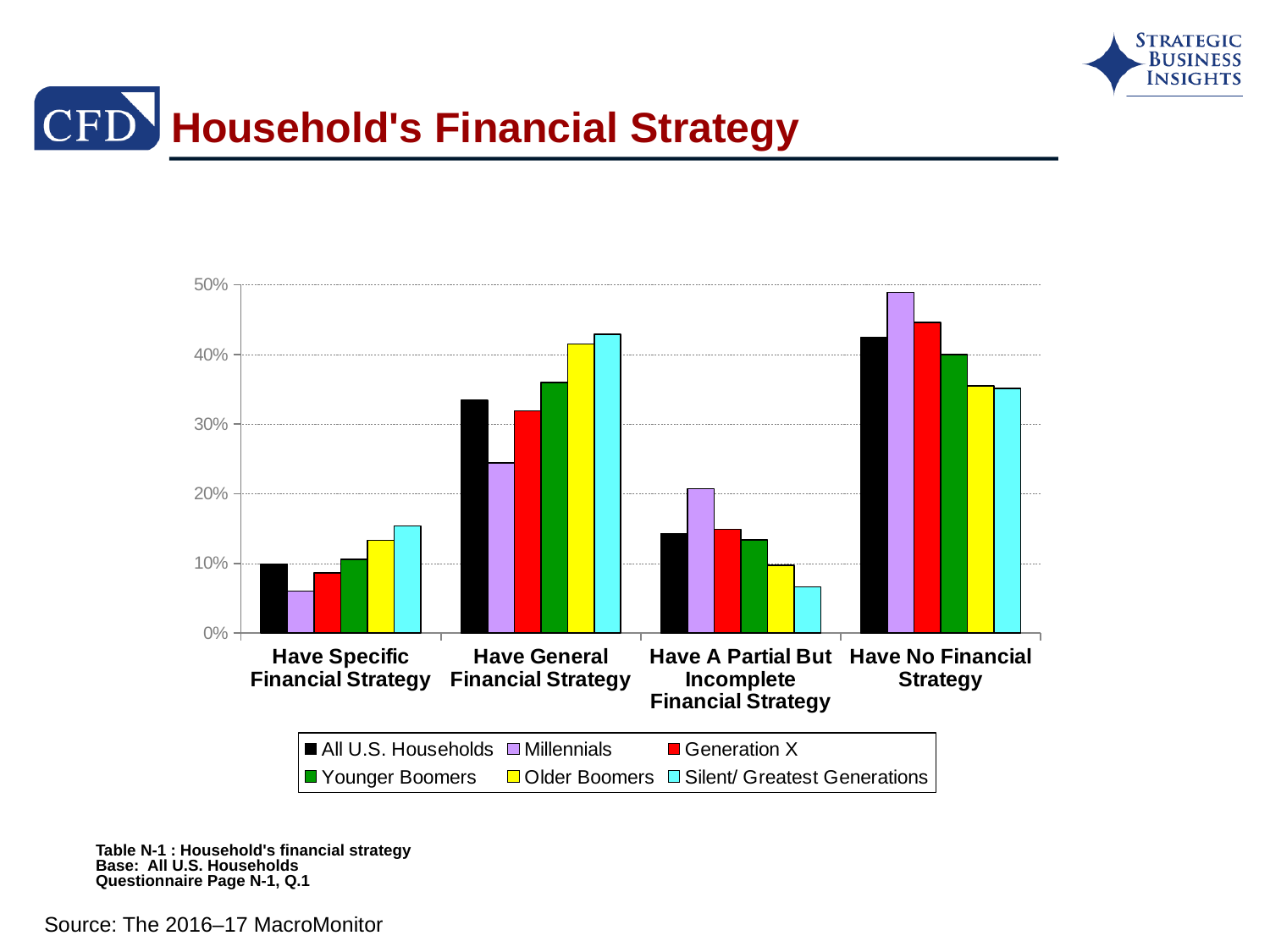
How many series does the legend list? 6 How many financial strategy categories are shown on the x axis? 4 What kind of chart is shown on the slide? bar chart Which series has the lowest bar in the 'Have A Partial But Incomplete Financial Strategy' category? Silent/ Greatest Generations Is the value for Silent/ Greatest Generations in 'Have General Financial Strategy' greater or less than 40%? greater Is the value for Millennials in 'Have General Financial Strategy' greater or less than 30%? less Which series has the highest bar in the 'Have No Financial Strategy' category? Millennials In the 'Have A Partial But Incomplete Financial Strategy' category, which is larger: Millennials or Older Boomers? Millennials What is the title of the chart on the slide? Household's Financial Strategy In the 'Have Specific Financial Strategy' category, which is larger: All U.S. Households or Silent/ Greatest Generations? Silent/ Greatest Generations Which series has the lowest bar in the 'Have Specific Financial Strategy' category? Millennials Is the value for Millennials in 'Have No Financial Strategy' greater or less than 40%? greater